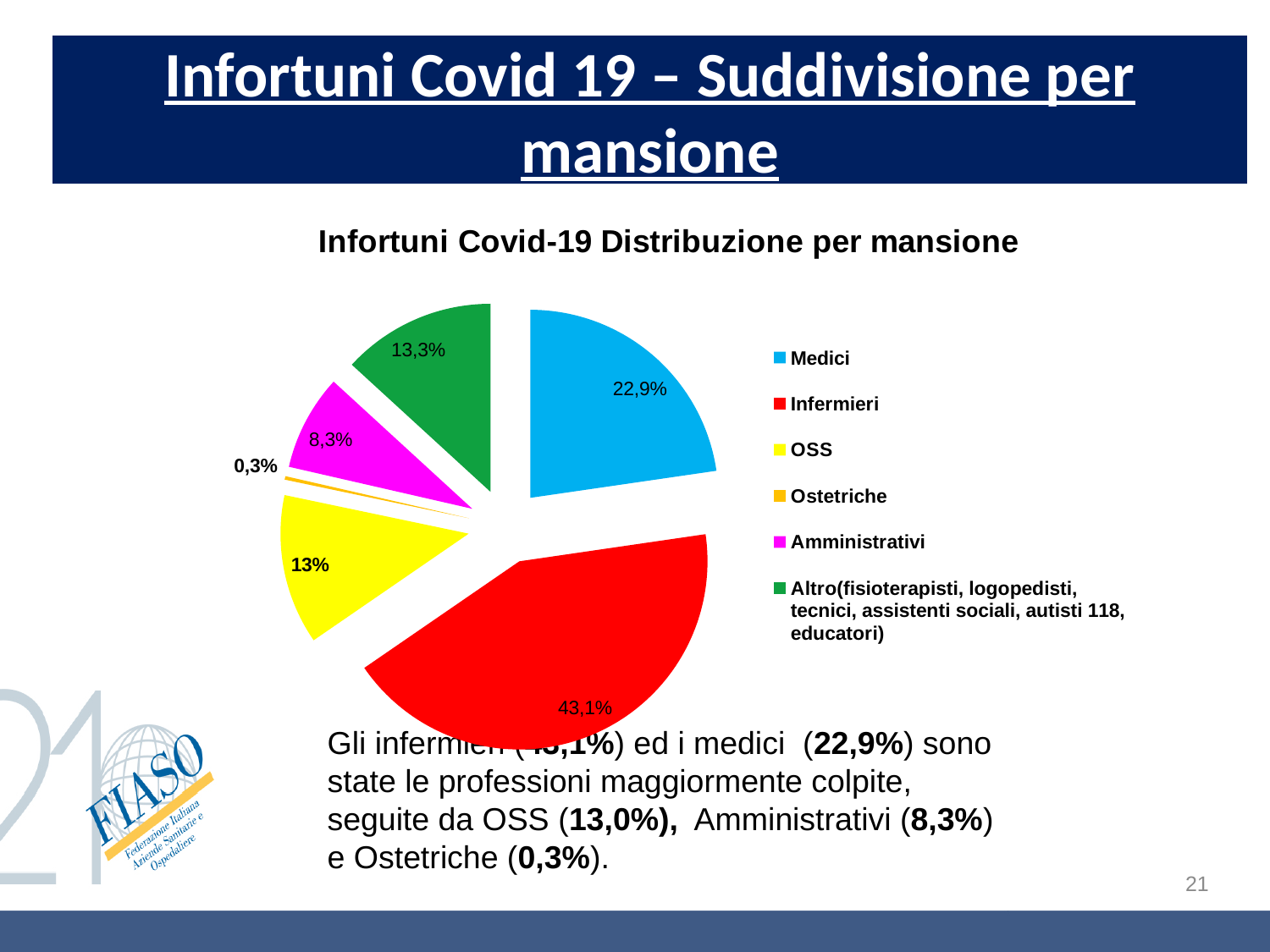
What kind of chart is shown on the slide? pie chart What percentage of Covid-19 injuries is attributed to Infermieri? 43,1% What is the value shown for the Ostetriche slice? 0,3% What is the difference in percentage points between Infermieri and Medici? 20,2% Which category has the largest share of the pie? Infermieri How many categories are shown in the pie chart? 6 Which is larger, the share for Medici or the share for Amministrativi? Medici Which category has the smallest share of the pie? Ostetriche What is the value shown for the Altro (fisioterapisti, logopedisti, tecnici, assistenti sociali, autisti 118, educatori) slice? 13,3% What percentage of Covid-19 injuries is attributed to Medici? 22,9% What colour is the Infermieri slice in the pie chart? red What is the value shown for the Amministrativi slice? 8,3%